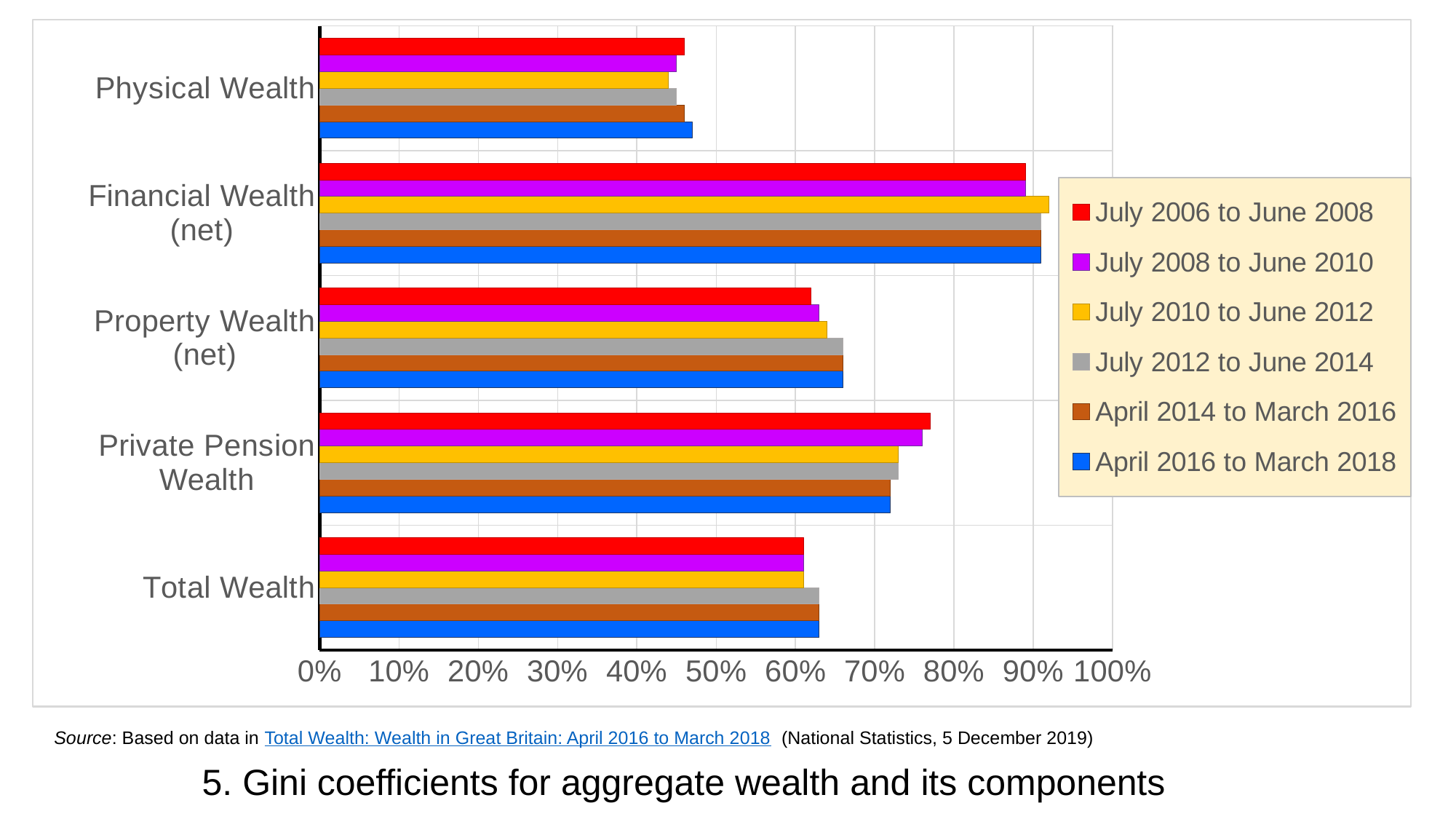
Is the value for Financial Wealth (net) in July 2010 to June 2012 greater or less than 90%? greater Which wealth category has the highest Gini coefficients across all periods? Financial Wealth (net) For Private Pension Wealth, which is larger: the value for July 2006 to June 2008 or the value for April 2016 to March 2018? July 2006 to June 2008 What kind of chart is shown on the slide? Bar chart For April 2016 to March 2018, which is larger: the value for Financial Wealth (net) or the value for Property Wealth (net)? Financial Wealth (net) Is the value for Private Pension Wealth in July 2006 to June 2008 greater or less than 70%? greater Which wealth category has the lowest Gini coefficients across all periods? Physical Wealth How many series does the legend list? 6 How many wealth categories are plotted on the chart? 5 Is the value for Physical Wealth in April 2016 to March 2018 greater or less than 50%? less What is the title of the chart? 5. Gini coefficients for aggregate wealth and its components